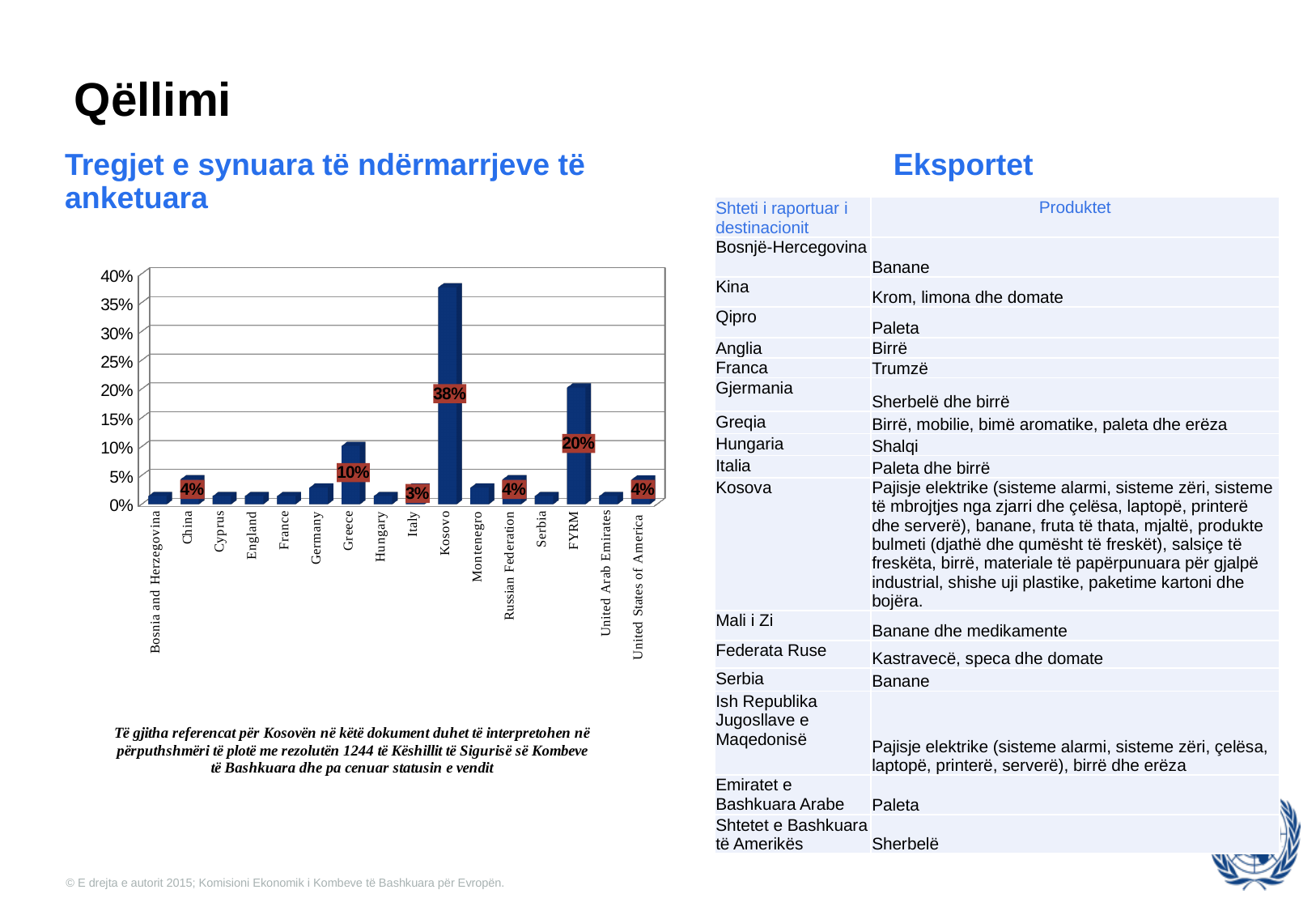
What is the value for Italy in the bar chart? 3% What is the difference between the values for Kosovo and FYRM? 18% What is the value for Greece in the bar chart? 10% How many categories are shown on the x axis of the chart? 16 What is the difference between the values for FYRM and Greece? 10% Is the value for Germany greater or less than 5%? less What is the value for FYRM in the bar chart? 20% Which category has the highest value in the bar chart? Kosovo What is the value for Kosovo in the bar chart? 38% What kind of chart is shown on the slide? bar chart What is the value for the Russian Federation in the bar chart? 4% Which is larger, the value for Greece or the value for Italy? Greece